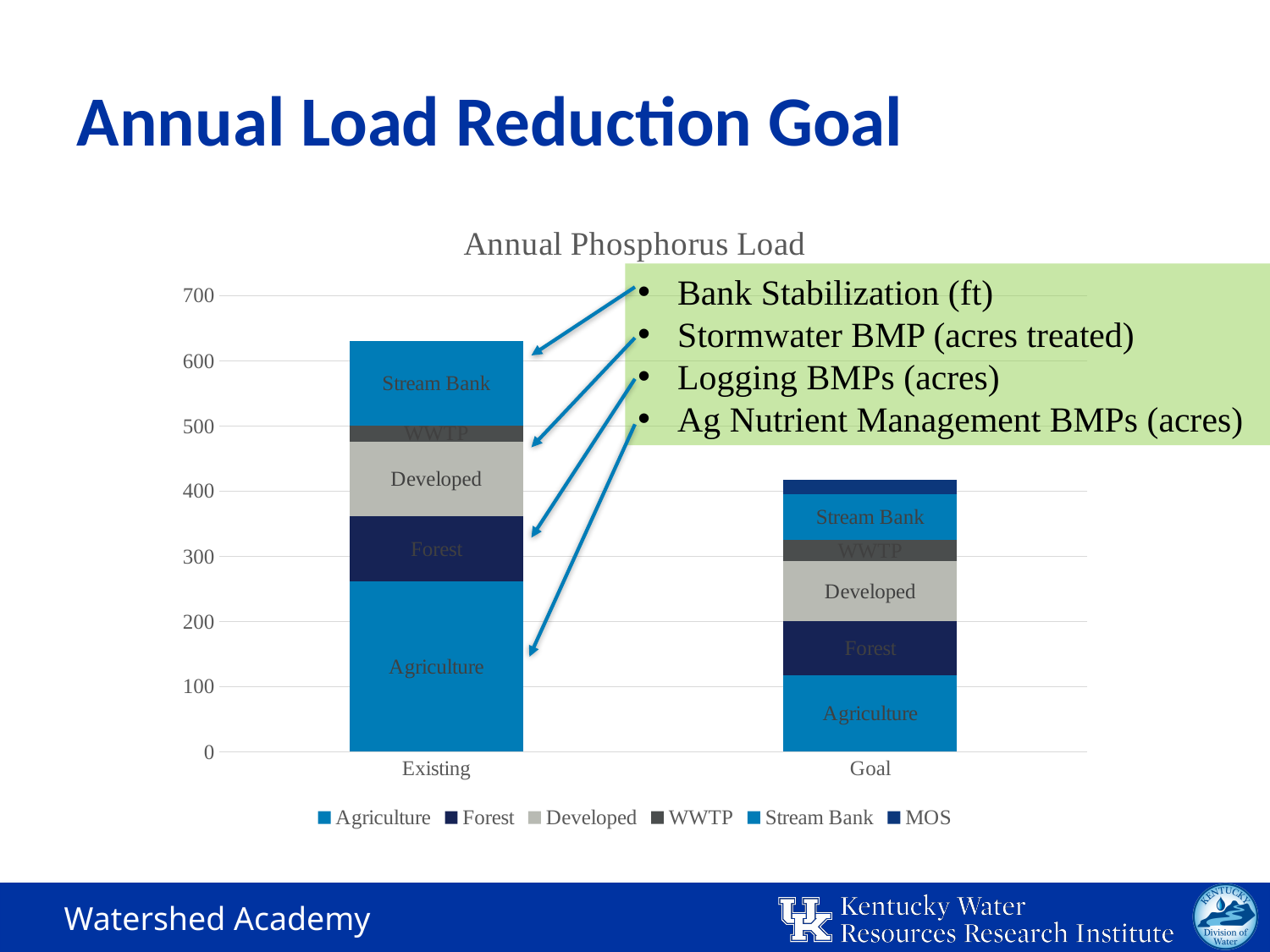
Which category has the lowest total annual phosphorus load? Goal Is the total of the Existing bar greater or less than 600? greater Is the Agriculture segment of the Goal bar greater or less than 200? less Is the Agriculture segment of the Existing bar greater or less than 200? greater What is the title of the chart? Annual Phosphorus Load What kind of chart is shown on the slide? Stacked bar chart How many categories are shown on the x axis of the chart? 2 Which category has the taller stacked bar, Existing or Goal? Existing Does the total annual phosphorus load rise or fall from Existing to Goal? fall Which series in the legend appears only in the Goal bar and not in the Existing bar? MOS How many series does the chart legend list? 6